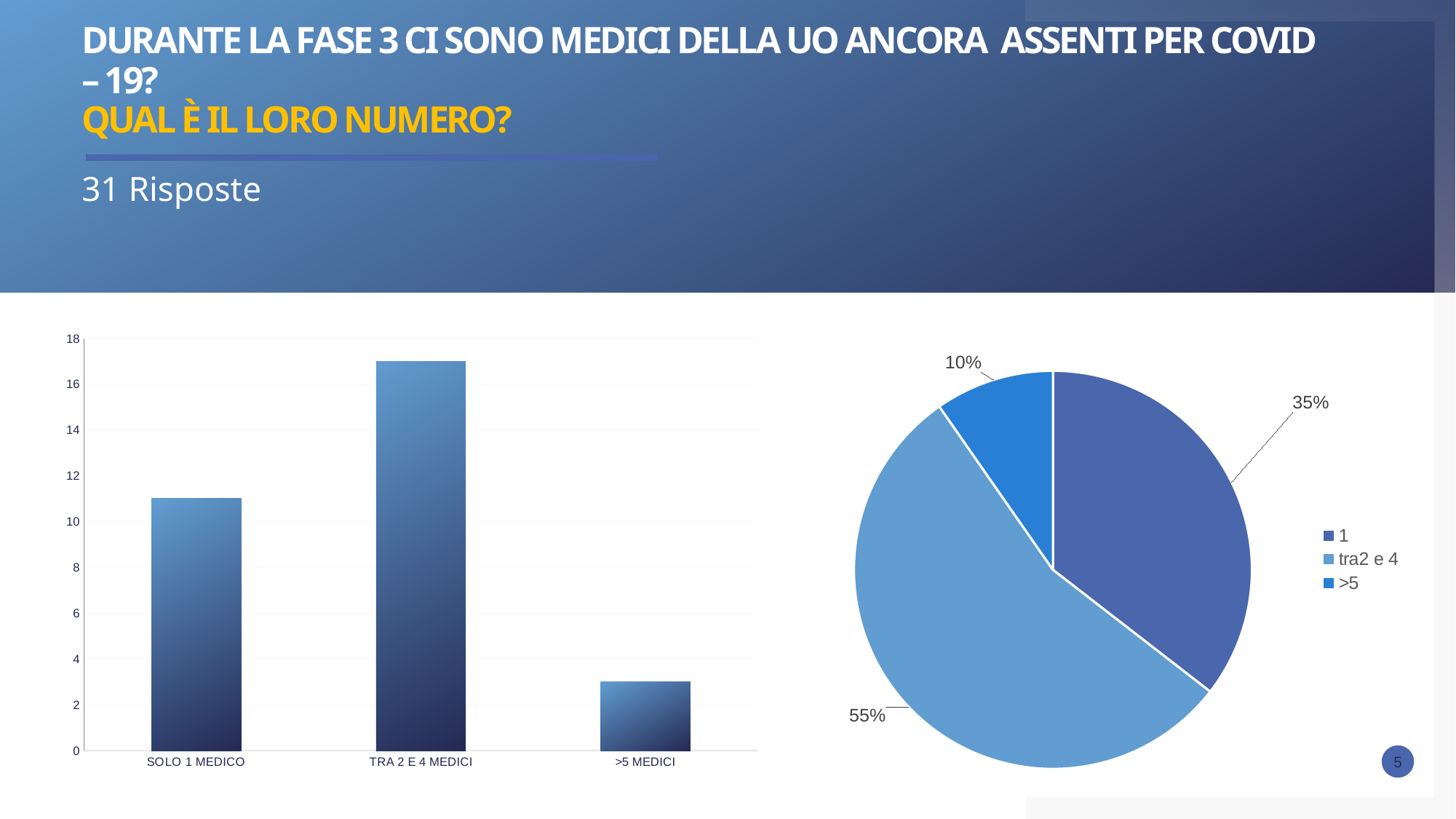
What kind of chart is the chart on the left of the slide? bar chart In the pie chart on the right, what share does the slice labelled 'tra2 e 4' have? 55% How many entries does the legend of the pie chart on the right list? 3 In the bar chart on the left, how many categories are shown on the x axis? 3 In the bar chart on the left, which category has the lowest bar? >5 MEDICI In the bar chart on the left, which category has the highest bar? TRA 2 E 4 MEDICI What kind of chart is the chart on the right of the slide? pie chart In the bar chart on the left, is the value for SOLO 1 MEDICO greater or less than 10? greater In the bar chart on the left, is the value for TRA 2 E 4 MEDICI greater or less than 16? greater In the bar chart on the left, which is larger, the value for SOLO 1 MEDICO or the value for >5 MEDICI? SOLO 1 MEDICO In the bar chart on the left, is the value for >5 MEDICI greater or less than 4? less In the pie chart on the right, what share does the slice labelled '>5' have? 10%